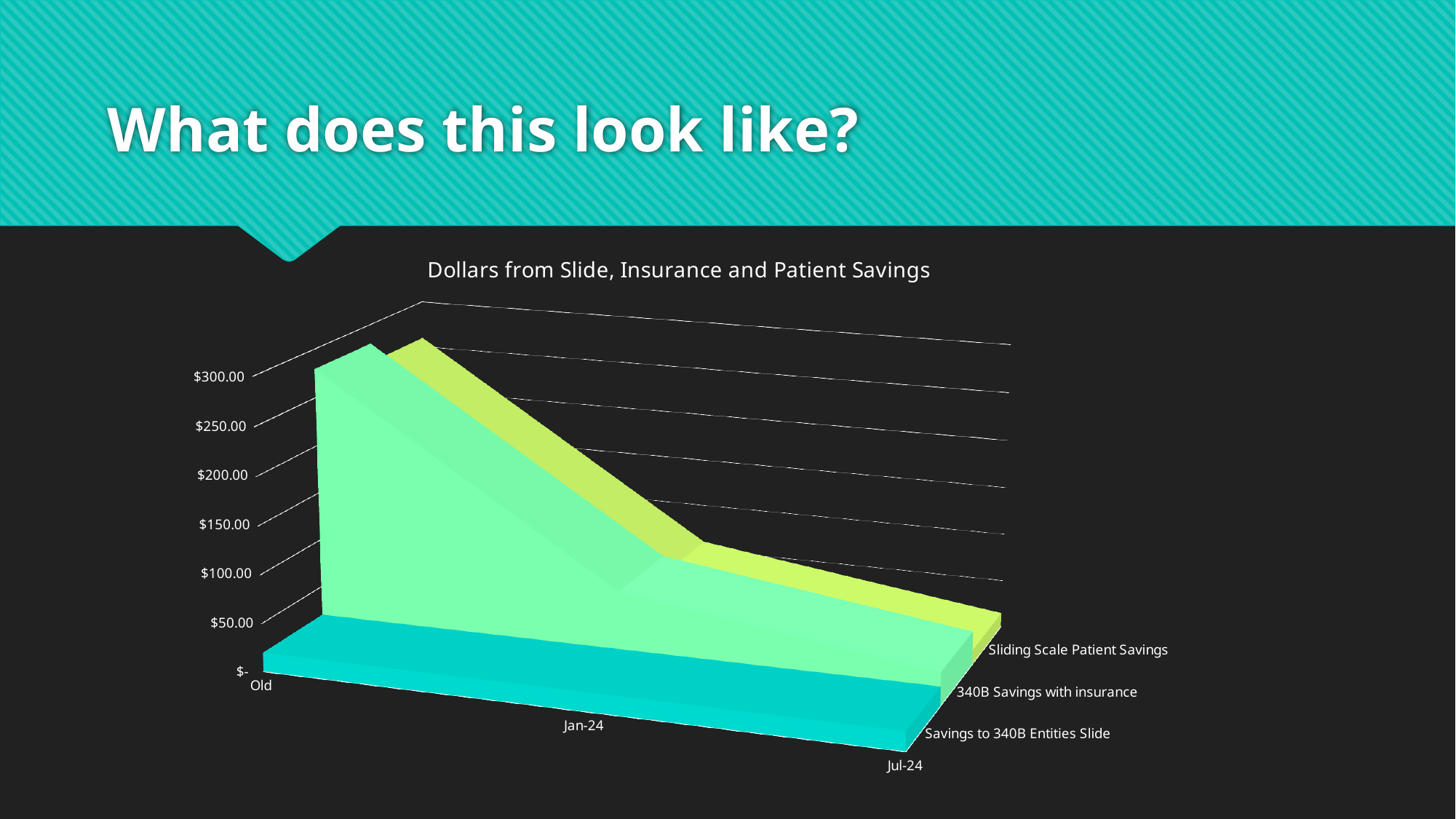
How many series does the chart plot? 3 At Old, which is larger: 340B Savings with insurance or Savings to 340B Entities Slide? 340B Savings with insurance How many categories are shown along the x axis of the chart? 3 What is the first category on the x axis of the chart? Old Is the value for Savings to 340B Entities Slide at Old greater or less than $150.00? less Do the values for Sliding Scale Patient Savings rise or fall from Old to Jul-24? fall Is the value for Sliding Scale Patient Savings at Jan-24 greater or less than $250.00? less What is the title of the chart? Dollars from Slide, Insurance and Patient Savings Which series is plotted at the front of the chart, closest to the viewer? Savings to 340B Entities Slide What kind of chart is shown on the slide? area chart Is the value for 340B Savings with insurance at Jan-24 greater or less than $250.00? less Do the values for 340B Savings with insurance rise or fall from Old to Jul-24? fall